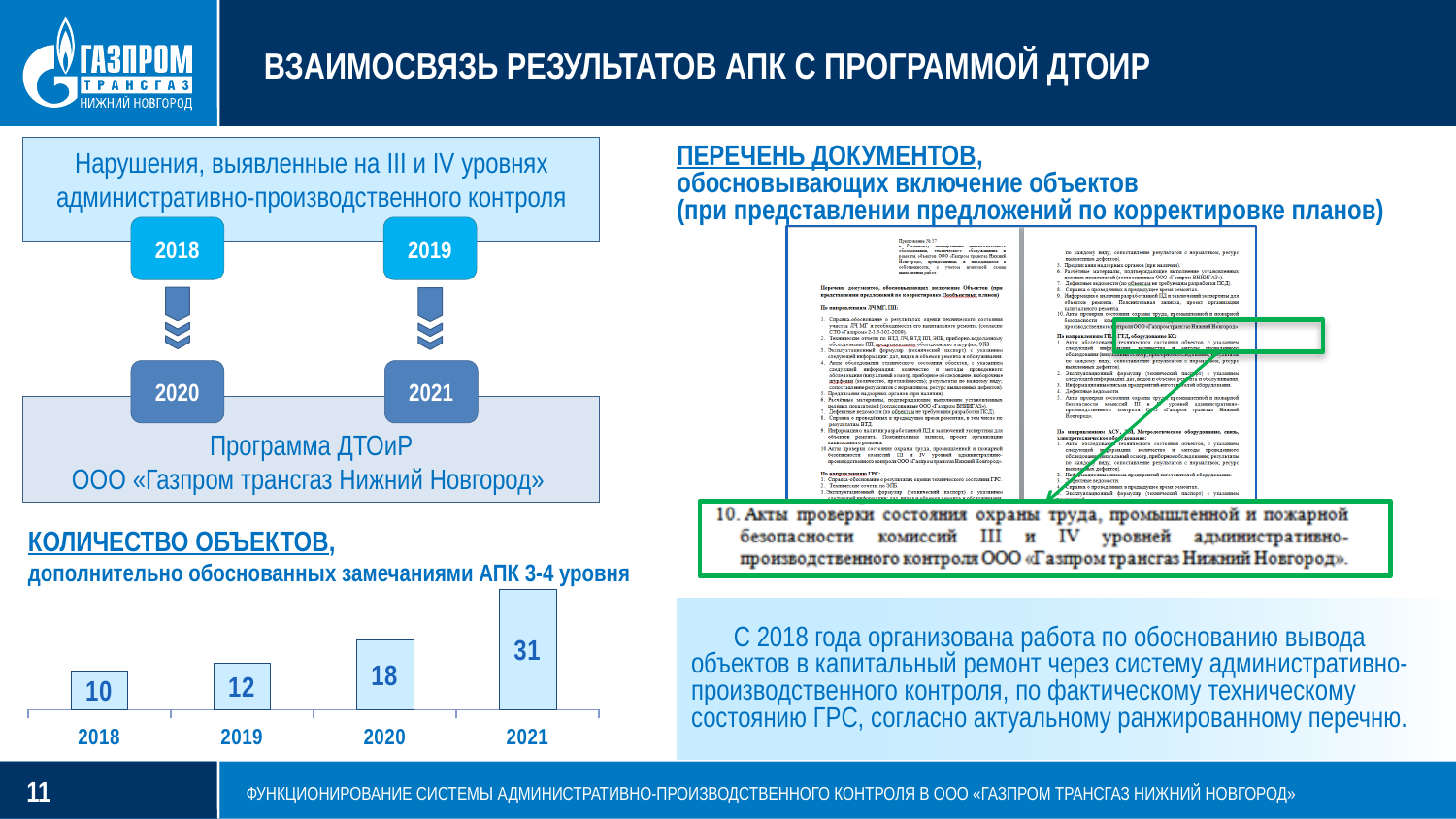
Which year has the highest value in the bar chart 'КОЛИЧЕСТВО ОБЪЕКТОВ'? 2021 Which year has the lowest value in the bar chart 'КОЛИЧЕСТВО ОБЪЕКТОВ'? 2018 How many years are shown in the bar chart 'КОЛИЧЕСТВО ОБЪЕКТОВ'? 4 What is the value for 2018 in the bar chart 'КОЛИЧЕСТВО ОБЪЕКТОВ'? 10 What kind of chart is used for 'КОЛИЧЕСТВО ОБЪЕКТОВ'? Bar chart In the bar chart 'КОЛИЧЕСТВО ОБЪЕКТОВ', what is the difference between the values for 2019 and 2018? 2 In the bar chart 'КОЛИЧЕСТВО ОБЪЕКТОВ', which is larger: the value for 2019 or the value for 2020? 2020 What is the value for 2021 in the bar chart 'КОЛИЧЕСТВО ОБЪЕКТОВ'? 31 What is the title of the bar chart at the bottom left of the slide? КОЛИЧЕСТВО ОБЪЕКТОВ, дополнительно обоснованных замечаниями АПК 3-4 уровня Do the values in the bar chart 'КОЛИЧЕСТВО ОБЪЕКТОВ' rise or fall from 2018 to 2021? Rise In the bar chart 'КОЛИЧЕСТВО ОБЪЕКТОВ', what is the difference between the values for 2021 and 2020? 13 What is the value for 2020 in the bar chart 'КОЛИЧЕСТВО ОБЪЕКТОВ'? 18